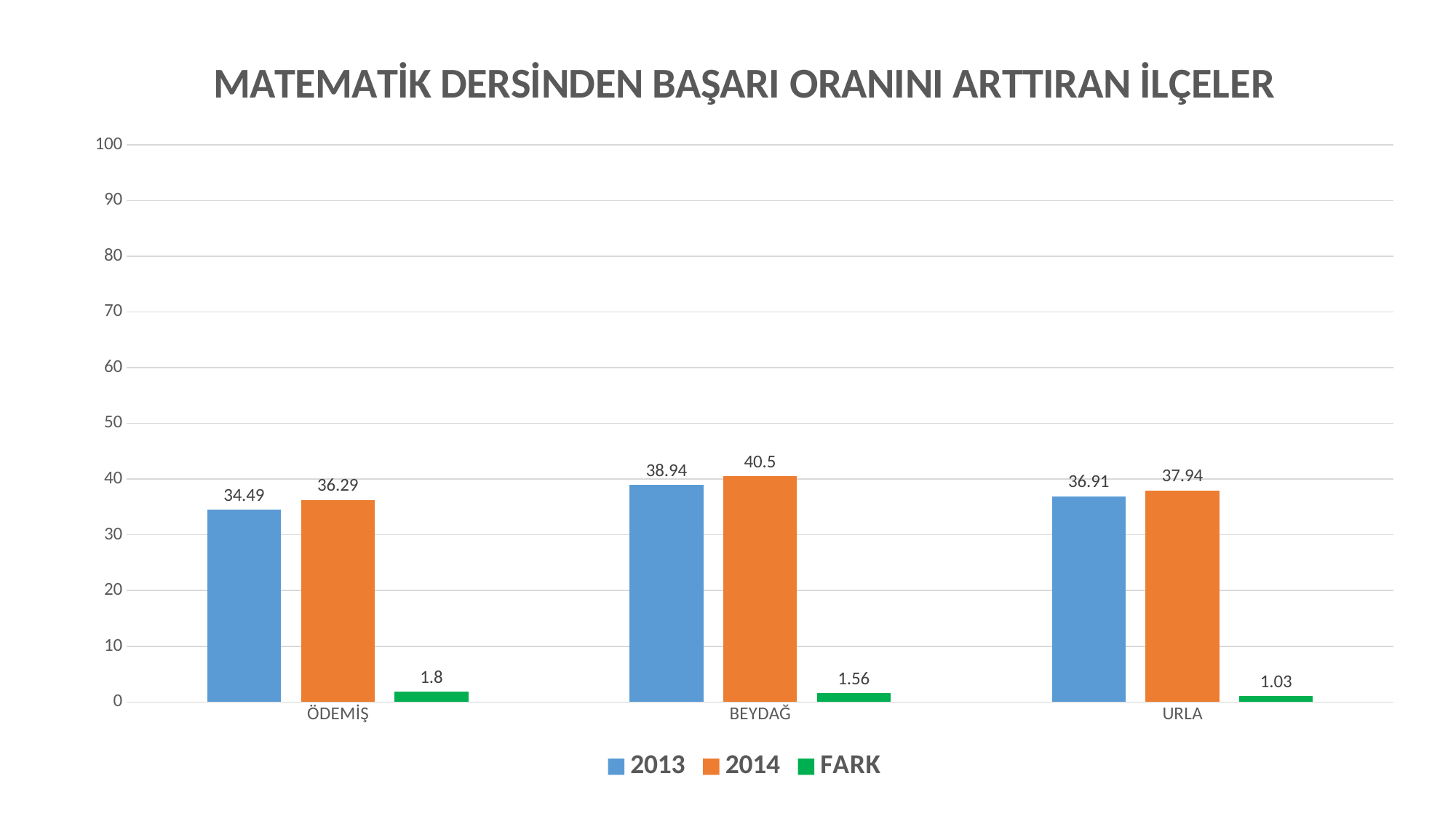
What is the FARK value for URLA? 1.03 What is the title of the chart? MATEMATİK DERSİNDEN BAŞARI ORANINI ARTTIRAN İLÇELER How many districts are shown on the x axis? 3 Is the 2014 value for ÖDEMİŞ greater or less than 40? less Which district has the highest 2014 value? BEYDAĞ What is the difference between the 2014 and 2013 values for URLA? 1.03 What is the 2013 value for ÖDEMİŞ? 34.49 What kind of chart is shown? bar chart What is the 2014 value for BEYDAĞ? 40.5 How many series does the legend list? 3 Which district has the lowest FARK value? URLA Which is larger, the 2013 value for BEYDAĞ or the 2013 value for URLA? BEYDAĞ